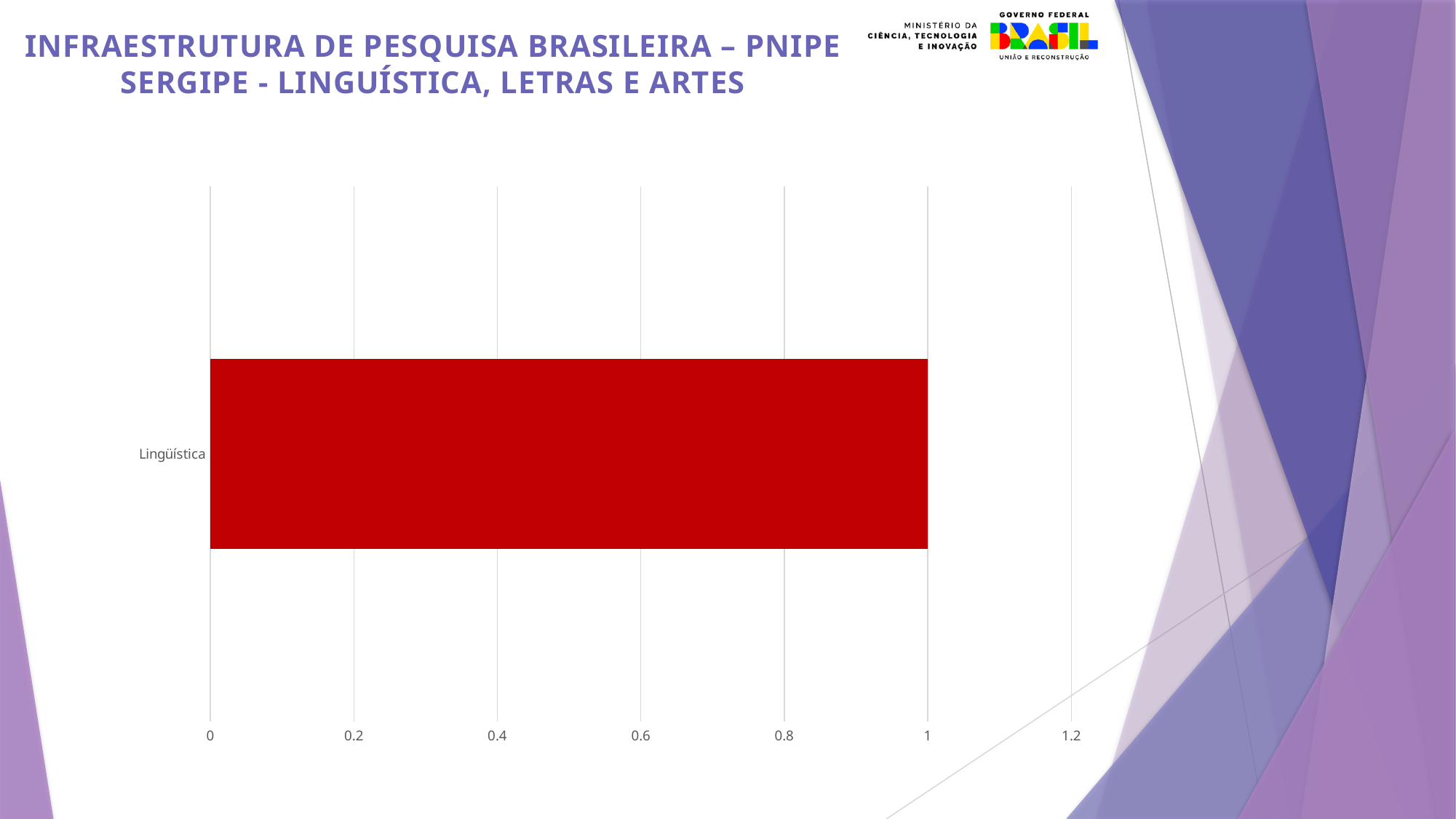
What kind of chart is shown on the slide? bar chart Which category has the highest value in the chart? Lingüística What is the value of the bar for Lingüística? 1 Is the value for Lingüística greater or less than 0.8? greater Is the value for Lingüística greater or less than 0.6? greater How many categories are plotted in the chart? 1 What is the label of the category shown on the vertical axis? Lingüística What colour is the bar in the chart? red Is the value for Lingüística greater or less than 1.2? less